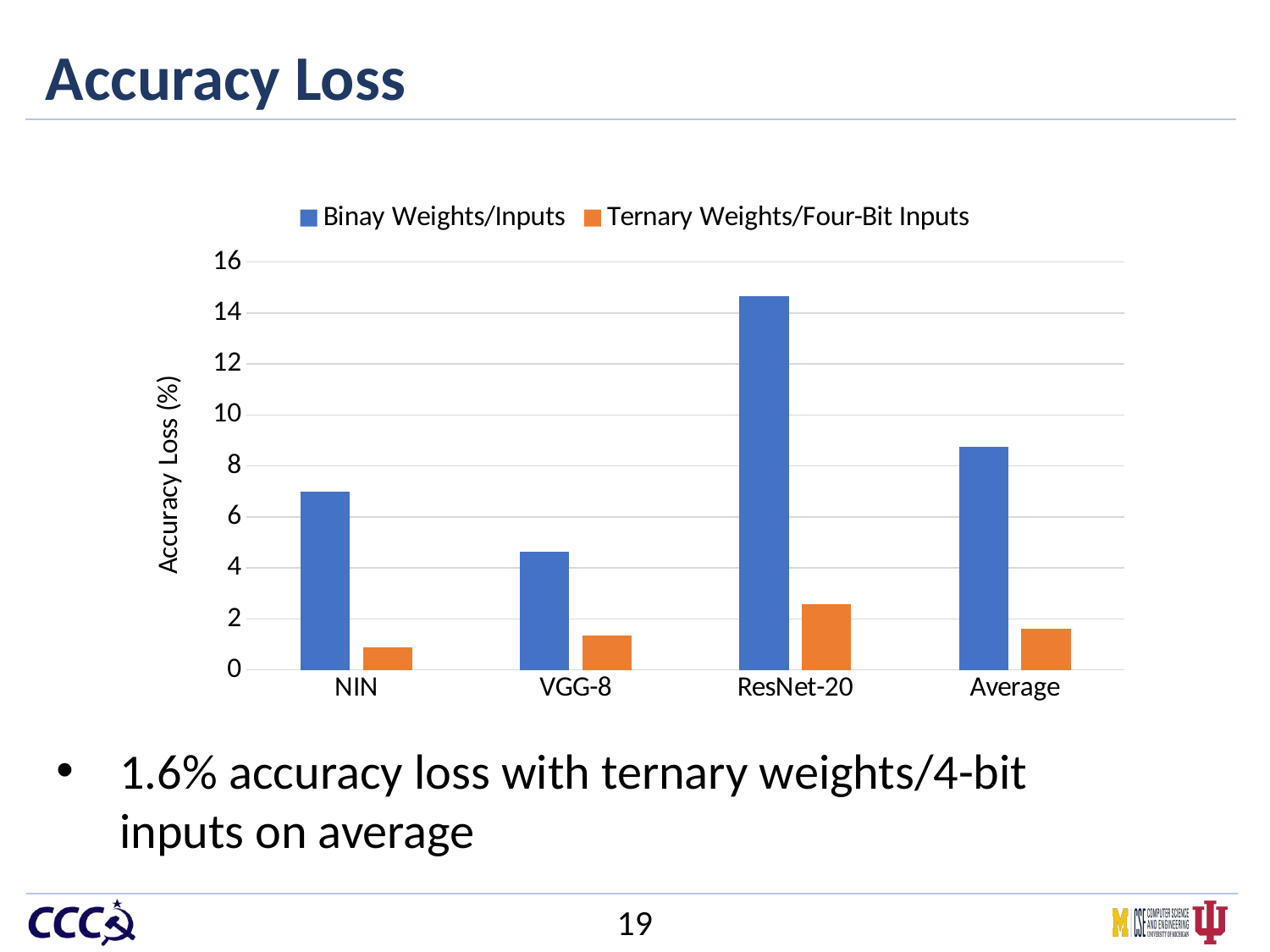
Which category has the lowest Ternary Weights/Four-Bit Inputs accuracy loss? NIN Is the Binay Weights/Inputs value for ResNet-20 greater or less than 14? greater How many series does the legend list? 2 Which category has the highest Ternary Weights/Four-Bit Inputs accuracy loss? ResNet-20 What kind of chart is shown on the slide? bar chart For VGG-8, which series has the larger accuracy loss, Binay Weights/Inputs or Ternary Weights/Four-Bit Inputs? Binay Weights/Inputs Which category has the lowest Binay Weights/Inputs accuracy loss? VGG-8 Is the Binay Weights/Inputs value for NIN greater or less than 8? less Is the Ternary Weights/Four-Bit Inputs value for ResNet-20 greater or less than 2? greater Which category has the highest Binay Weights/Inputs accuracy loss? ResNet-20 How many categories are shown on the x axis? 4 What is the label of the y axis? Accuracy Loss (%)